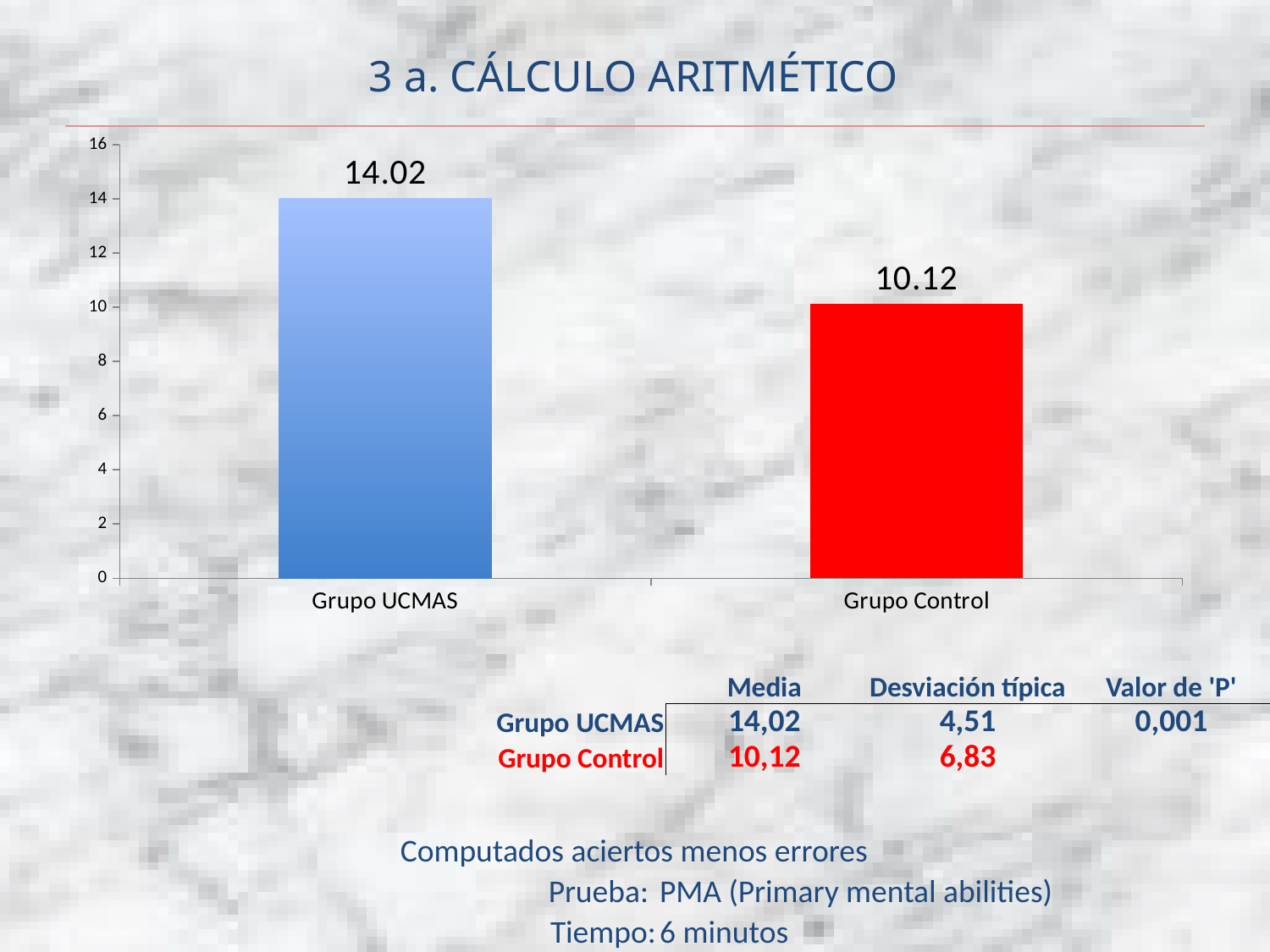
What is the value for Grupo Control? 10.12 What is the title of the slide above the chart? 3 a. CÁLCULO ARITMÉTICO How many categories are shown on the chart? 2 Which group has the lowest value? Grupo Control Is the value for Grupo Control greater or less than 12? less What is the difference between the values for Grupo UCMAS and Grupo Control? 3.9 Which group has the highest value? Grupo UCMAS What colour is the bar for Grupo Control? red What is the value for Grupo UCMAS? 14.02 Is the value for Grupo UCMAS greater or less than 12? greater Which is larger, the value for Grupo UCMAS or the value for Grupo Control? Grupo UCMAS What kind of chart is shown on the slide? bar chart